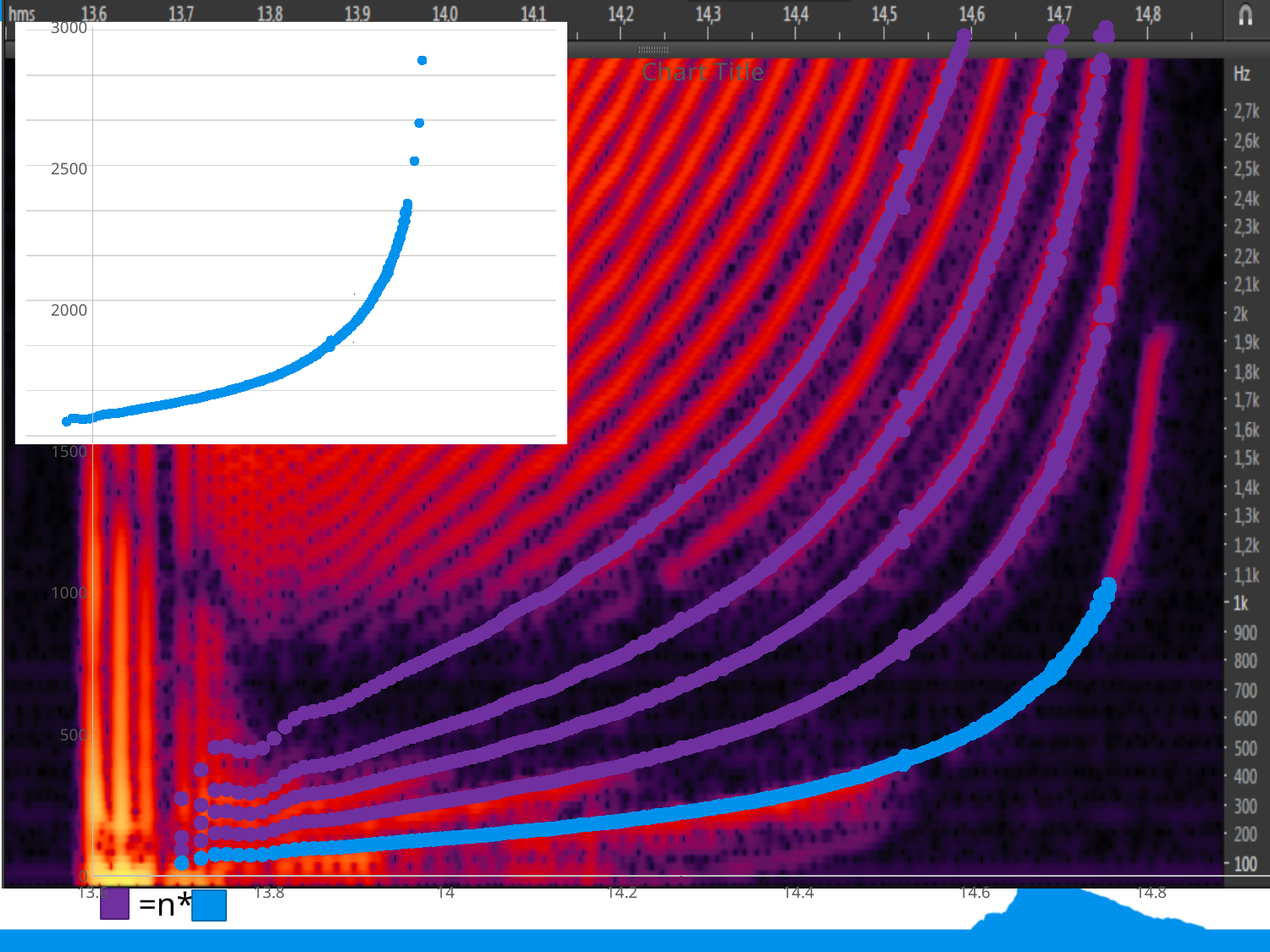
What is the title shown on the large chart? Chart Title In the large chart, is the highest purple series value at x = 14.6 greater or less than 2500? greater In the large chart, is the blue series value at x = 14.4 greater or less than 500? less In the large chart, do the blue series values rise or fall as the x-axis value increases? rise In the inset chart in the top-left corner, is the highest plotted point greater or less than 2500? greater In the large chart, which series reaches higher values, the purple series or the blue series? purple What two colours are used for the series in the large chart's legend? purple and blue What kind of chart is the inset chart in the top-left corner of the slide? scatter chart In the inset chart in the top-left corner, do the values rise or fall as the x-axis value increases? rise What kind of chart is the large chart overlaid on the spectrogram? scatter chart